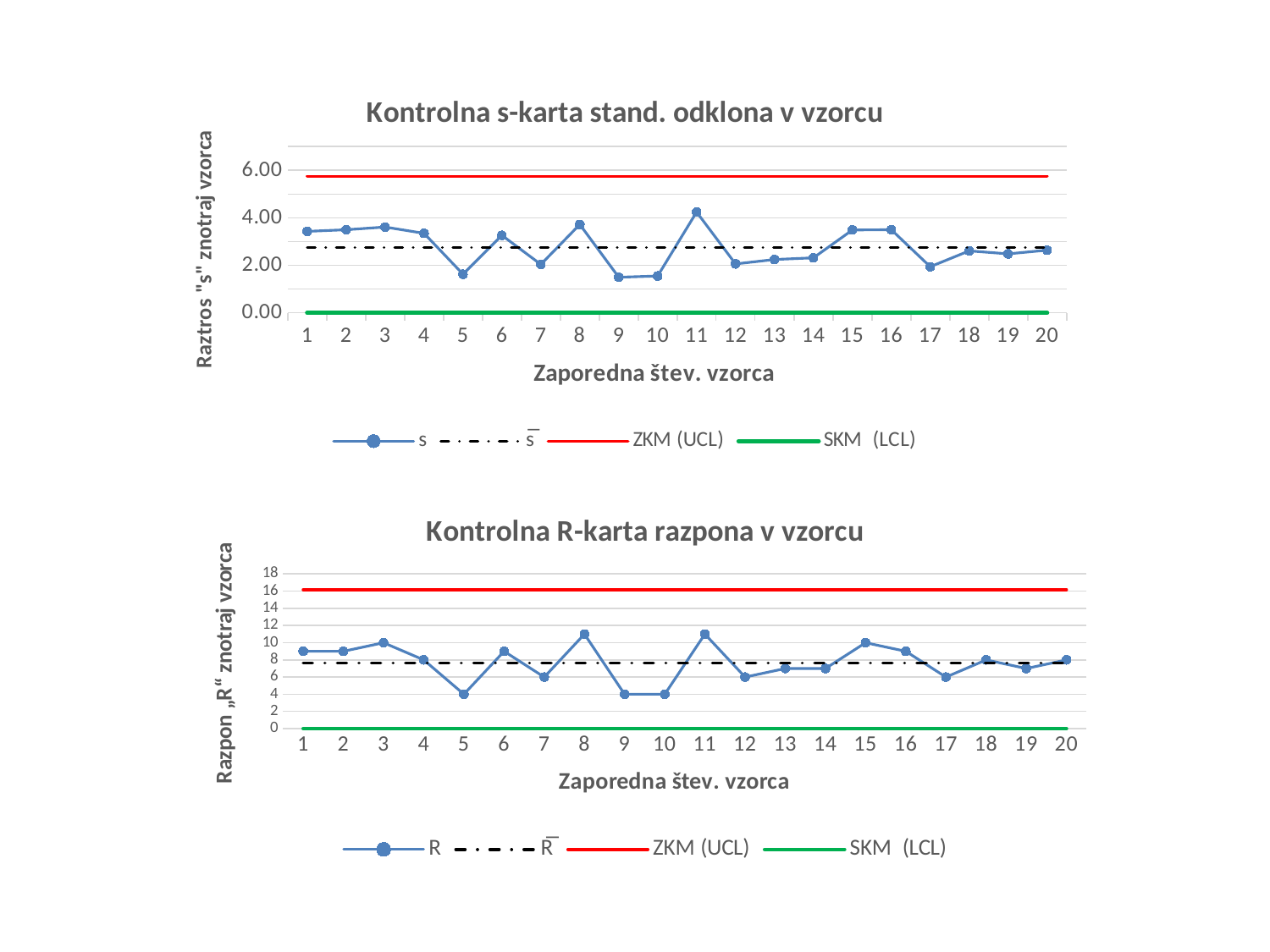
In the top chart 'Kontrolna s-karta stand. odklona v vzorcu', what colour is the ZKM (UCL) line? red In the bottom chart 'Kontrolna R-karta razpona v vzorcu', which has the larger value of R: sample 3 or sample 7? sample 3 In the bottom chart 'Kontrolna R-karta razpona v vzorcu', is the value of R for sample 8 greater or less than 10? greater What type of chart is the top chart, 'Kontrolna s-karta stand. odklona v vzorcu'? line chart In the top chart 'Kontrolna s-karta stand. odklona v vzorcu', is the value of s for sample 1 greater or less than 2.00? greater In the top chart 'Kontrolna s-karta stand. odklona v vzorcu', which sample number has the highest value of s? 11 In the top chart 'Kontrolna s-karta stand. odklona v vzorcu', is the value of s for sample 9 greater or less than 2.00? less In the top chart 'Kontrolna s-karta stand. odklona v vzorcu', how many series does the legend list? 4 In the top chart 'Kontrolna s-karta stand. odklona v vzorcu', how many samples are plotted along the x axis? 20 In the bottom chart 'Kontrolna R-karta razpona v vzorcu', how many series does the legend list? 4 In the top chart 'Kontrolna s-karta stand. odklona v vzorcu', which has the larger value of s: sample 11 or sample 5? sample 11